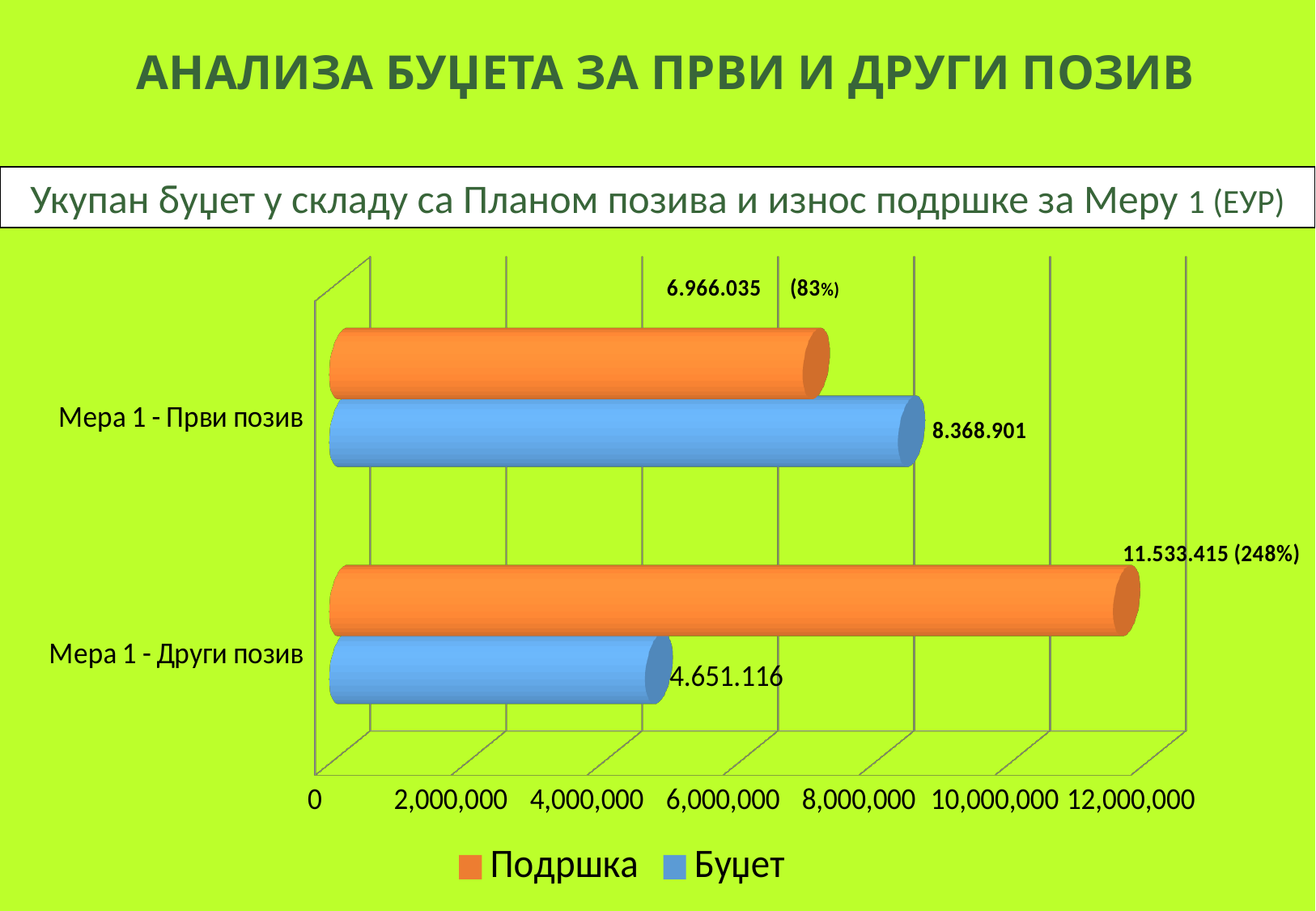
Which bar has the lowest value on the chart? Буџет for Мера 1 - Други позив What percentage is shown next to the Подршка value for Мера 1 - Други позив? 248% How many series does the legend list? 2 What is the value of Подршка for Мера 1 - Други позив? 11.533.415 What kind of chart is shown on the slide? Bar chart What is the difference between Буџет and Подршка for Мера 1 - Први позив? 1.402.866 What is the value of Буџет for Мера 1 - Први позив? 8.368.901 What is the value of Подршка for Мера 1 - Први позив? 6.966.035 What is the difference between Подршка and Буџет for Мера 1 - Други позив? 6.882.299 For Мера 1 - Први позив, which is larger: Подршка or Буџет? Буџет Which bar has the highest value on the chart? Подршка for Мера 1 - Други позив What is the value of Буџет for Мера 1 - Други позив? 4.651.116